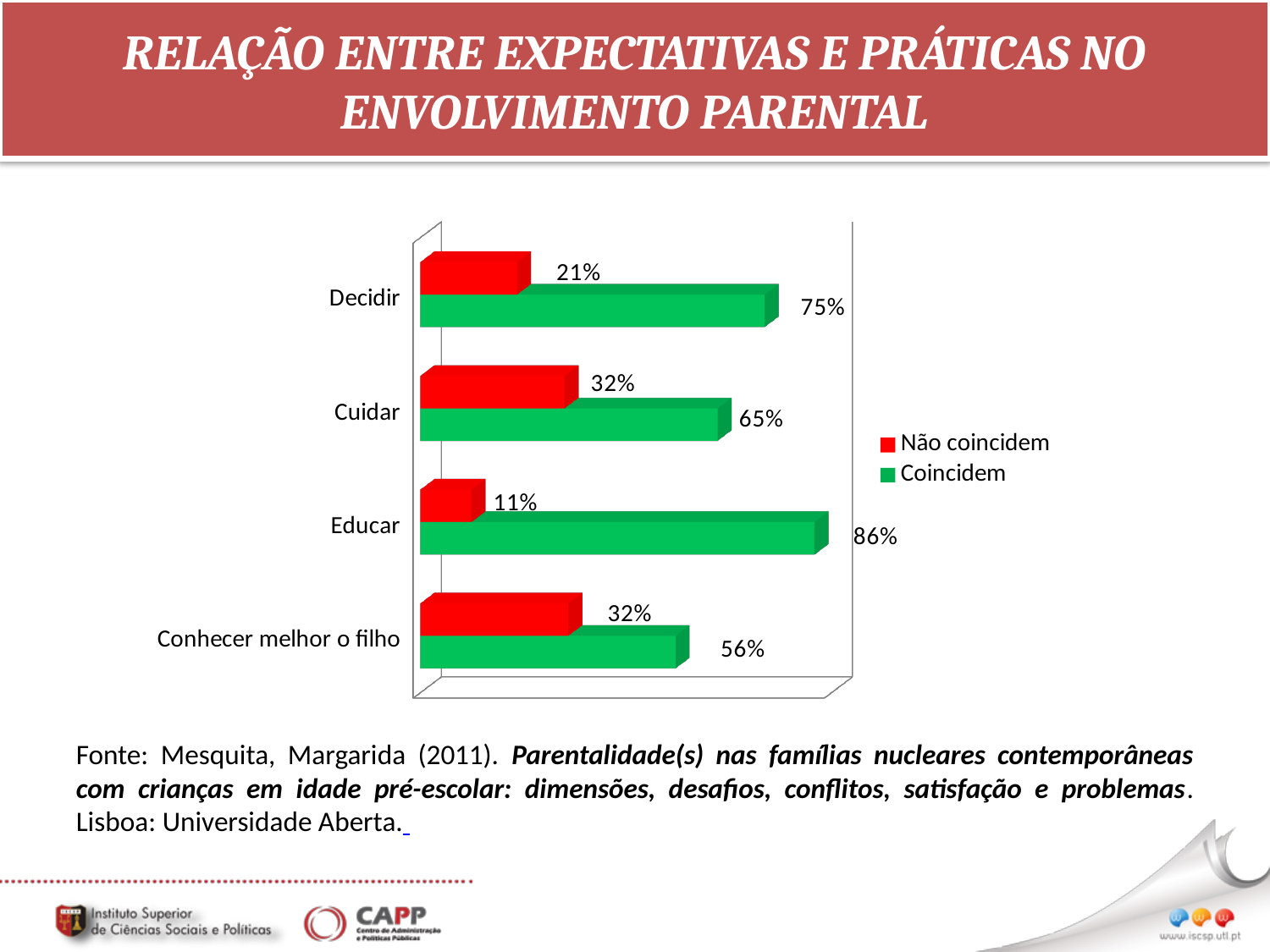
What is the value of "Não coincidem" for Cuidar? 32% What is the difference between the "Coincidem" and "Não coincidem" values for Decidir? 54% What kind of chart is shown on the slide? Bar chart Which category has the lowest "Não coincidem" value? Educar Which category has the highest "Coincidem" value? Educar What is the value of "Coincidem" for Educar? 86% How many series does the legend list? 2 How many categories are shown on the chart? 4 What is the value of "Não coincidem" for Decidir? 21% Which colour represents the "Não coincidem" series? Red Which is larger for Cuidar: "Coincidem" or "Não coincidem"? Coincidem What is the value of "Coincidem" for Conhecer melhor o filho? 56%